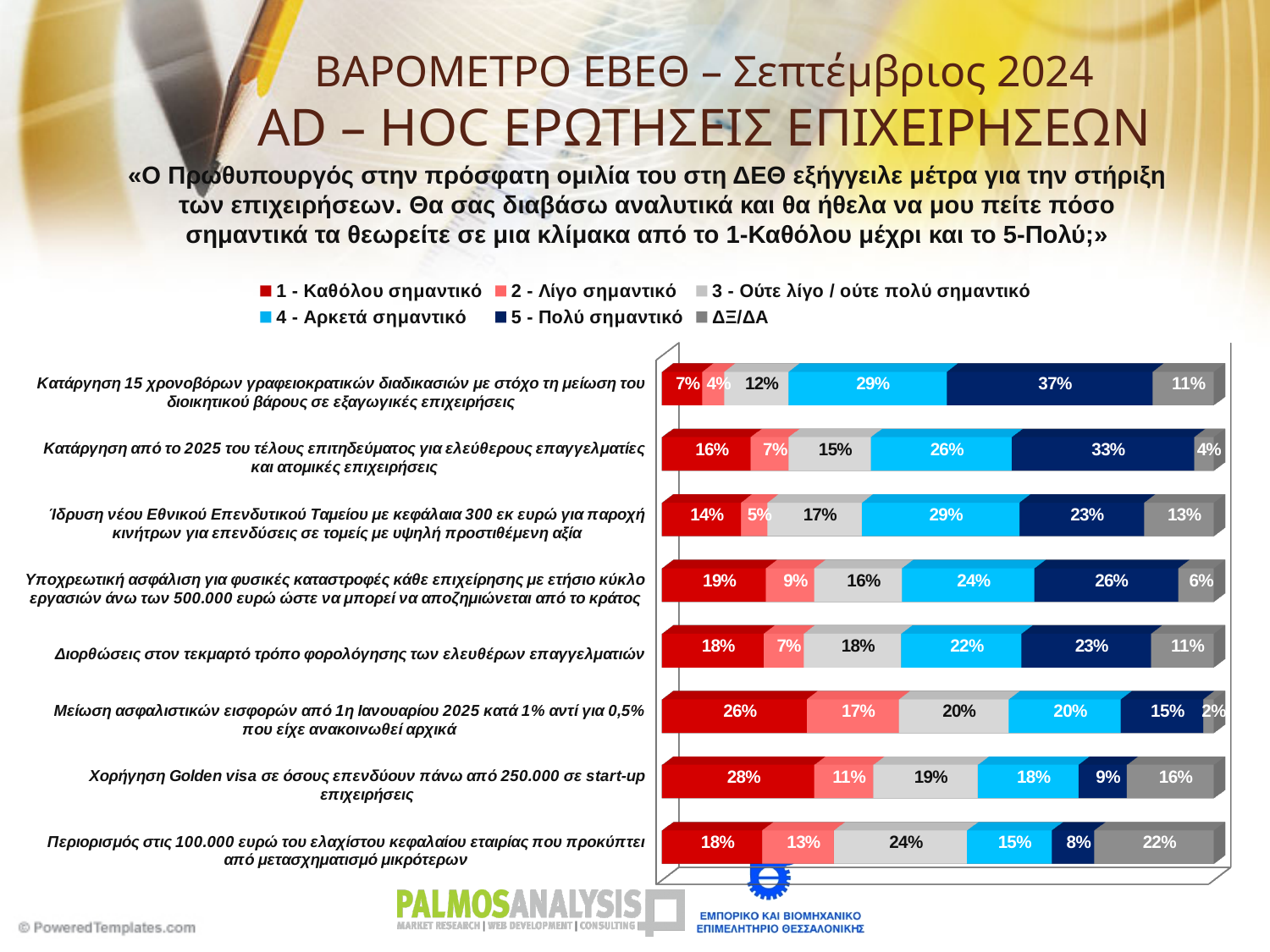
Which legend entry is shown in the darkest blue colour? 5 - Πολύ σημαντικό What is the value for '1 - Καθόλου σημαντικό' for 'Χορήγηση Golden visa σε όσους επενδύουν πάνω από 250.000 σε start-up επιχειρήσεις'? 28% How many measures (categories) are plotted in the chart? 8 What is the value for 'ΔΞ/ΔΑ' for 'Περιορισμός στις 100.000 ευρώ του ελαχίστου κεφαλαίου εταιρίας που προκύπτει από μετασχηματισμό μικρότερων'? 22% Which is larger: the '4 - Αρκετά σημαντικό' value for 'Ίδρυση νέου Εθνικού Επενδυτικού Ταμείου με κεφάλαια 300 εκ ευρώ για παροχή κινήτρων για επενδύσεις σε τομείς με υψηλή προστιθέμενη αξία' or for 'Διορθώσεις στον τεκμαρτό τρόπο φορολόγησης των ελευθέρων επαγγελματιών'? Ίδρυση νέου Εθνικού Επενδυτικού Ταμείου με κεφάλαια 300 εκ ευρώ για παροχή κινήτρων για επενδύσεις σε τομείς με υψηλή προστιθέμενη αξία What is the value for '2 - Λίγο σημαντικό' for 'Μείωση ασφαλιστικών εισφορών από 1η Ιανουαρίου 2025 κατά 1% αντί για 0,5% που είχε ανακοινωθεί αρχικά'? 17% Which measure has the highest value for '5 - Πολύ σημαντικό'? Κατάργηση 15 χρονοβόρων γραφειοκρατικών διαδικασιών με στόχο τη μείωση του διοικητικού βάρους σε εξαγωγικές επιχειρήσεις What is the difference between the '5 - Πολύ σημαντικό' values for 'Κατάργηση από το 2025 του τέλους επιτηδεύματος για ελεύθερους επαγγελματίες και ατομικές επιχειρήσεις' and 'Χορήγηση Golden visa σε όσους επενδύουν πάνω από 250.000 σε start-up επιχειρήσεις'? 24% What is the value for '5 - Πολύ σημαντικό' for 'Κατάργηση 15 χρονοβόρων γραφειοκρατικών διαδικασιών με στόχο τη μείωση του διοικητικού βάρους σε εξαγωγικές επιχειρήσεις'? 37% Which measure has the lowest value for '1 - Καθόλου σημαντικό'? Κατάργηση 15 χρονοβόρων γραφειοκρατικών διαδικασιών με στόχο τη μείωση του διοικητικού βάρους σε εξαγωγικές επιχειρήσεις What type of chart is shown on the slide? Stacked bar chart How many series does the legend list? 6